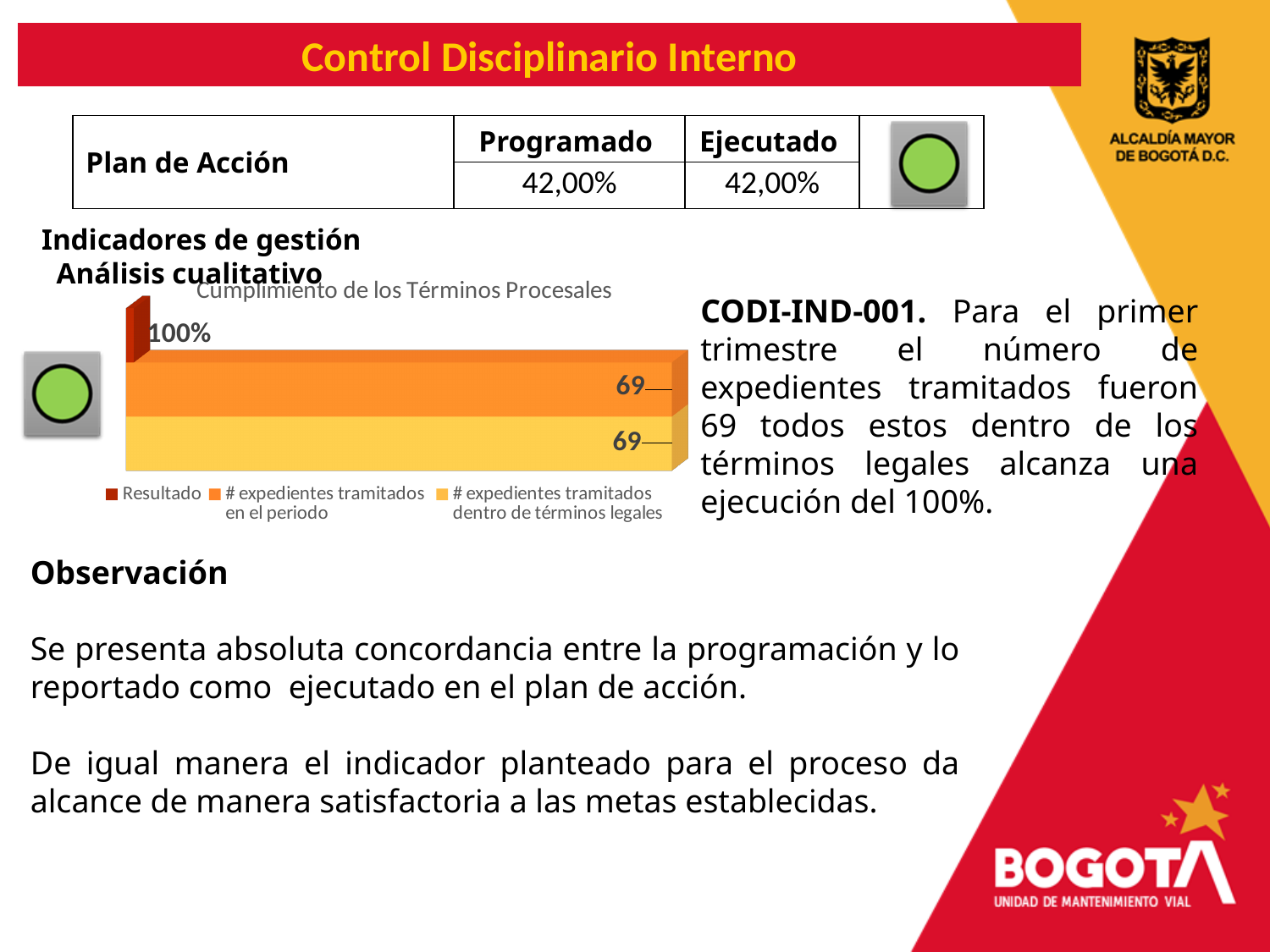
How many bars are plotted in the chart? 3 What is the title of the chart on the slide? Cumplimiento de los Términos Procesales What value is shown for the "Resultado" series in the chart? 100% How many series does the legend of the chart list? 3 What value is shown for "# expedientes tramitados en el periodo" in the chart? 69 What kind of chart is shown under "Cumplimiento de los Términos Procesales"? bar chart What is the difference between the values for "# expedientes tramitados en el periodo" and "# expedientes tramitados dentro de términos legales"? 0 What value is shown for "# expedientes tramitados dentro de términos legales" in the chart? 69 Which legend entry in the chart is shown in dark red? Resultado